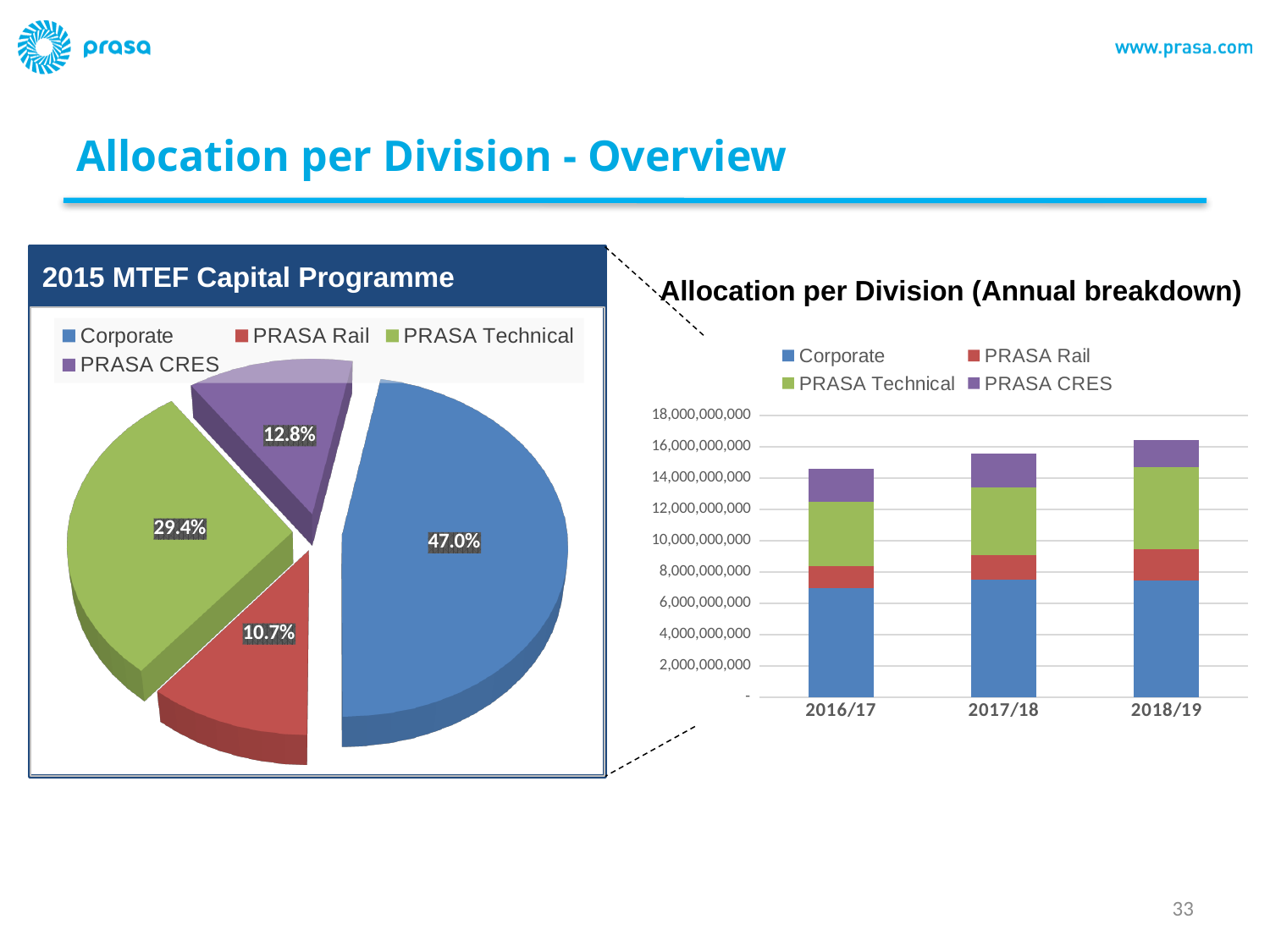
In the 2015 MTEF Capital Programme pie chart, which is larger, the PRASA CRES share or the PRASA Rail share? PRASA CRES How many series does the legend of the Allocation per Division (Annual breakdown) chart list? 4 What kind of chart is the Allocation per Division (Annual breakdown) chart? Stacked bar chart In the 2015 MTEF Capital Programme pie chart, which division has the largest share? Corporate In the Allocation per Division (Annual breakdown) chart, is the total for 2018/19 greater or less than 16,000,000,000? greater In the 2015 MTEF Capital Programme pie chart, which division has the smallest share? PRASA Rail In the 2015 MTEF Capital Programme pie chart, what share does PRASA Technical have? 29.4% In the 2015 MTEF Capital Programme pie chart, what is the difference between the Corporate share and the PRASA Technical share? 17.6% In the 2015 MTEF Capital Programme pie chart, what share does Corporate have? 47.0% How many slices does the 2015 MTEF Capital Programme pie chart have? 4 In the 2015 MTEF Capital Programme pie chart, what share does PRASA Rail have? 10.7% In the Allocation per Division (Annual breakdown) chart, do the total bar heights rise or fall from 2016/17 to 2018/19? Rise